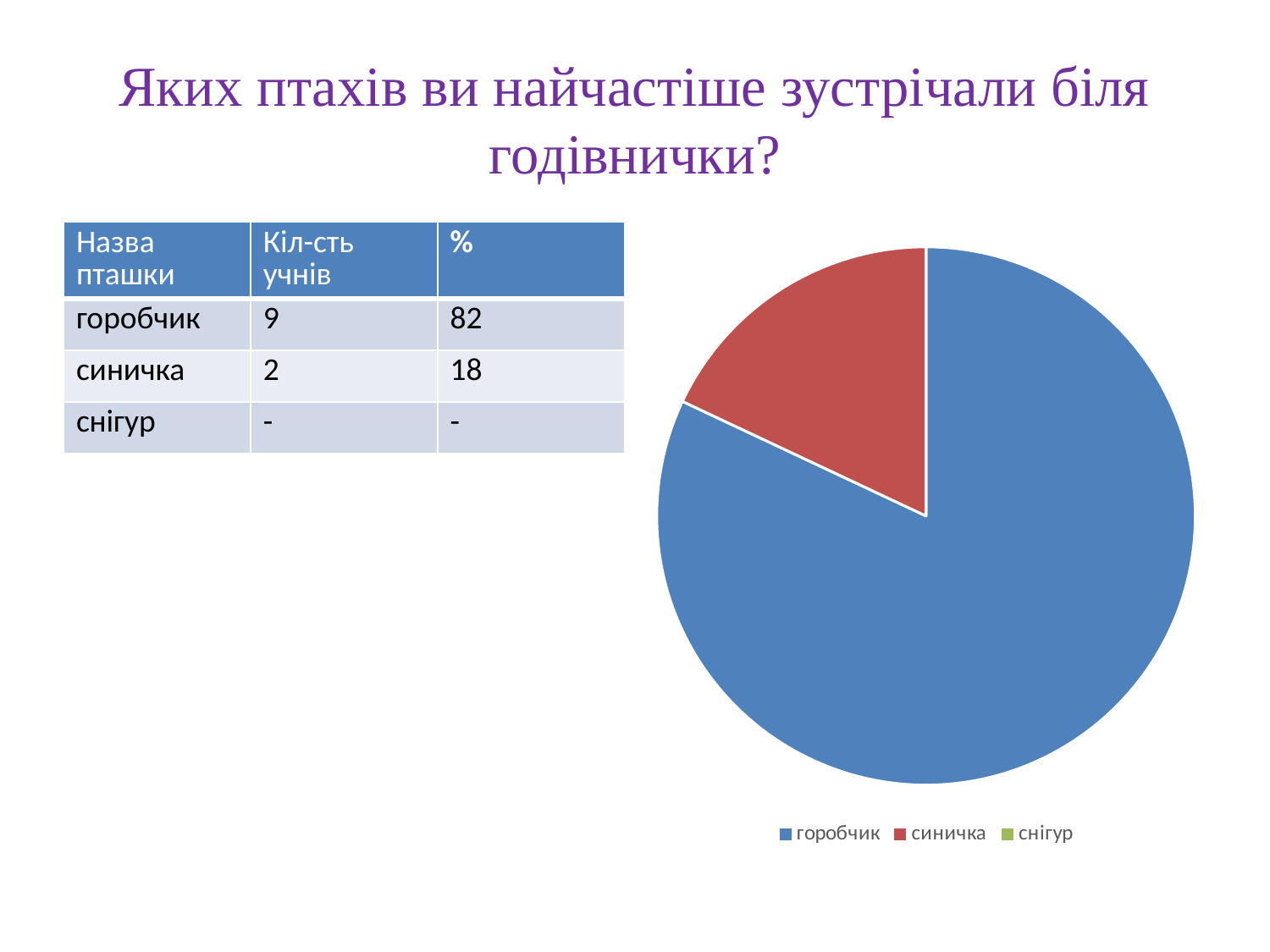
Is the share of the pie for горобчик greater or less than 50%? greater What colour is the slice for синичка in the pie chart? red How many entries does the pie chart's legend list? 3 According to the table, how many students (Кіл-сть учнів) chose горобчик? 9 What is the total number of students counted for горобчик and синичка together? 11 According to the table, what percentage corresponds to синичка? 18 Which legend entry has no visible slice in the pie chart? снігур Which of the two visible slices in the pie chart is smaller, горобчик or синичка? синичка What share of the pie does горобчик take, according to the % column of the table? 82 What kind of chart is shown on the slide? pie chart Which bird has the largest slice in the pie chart? горобчик How many more students chose горобчик than синичка? 7